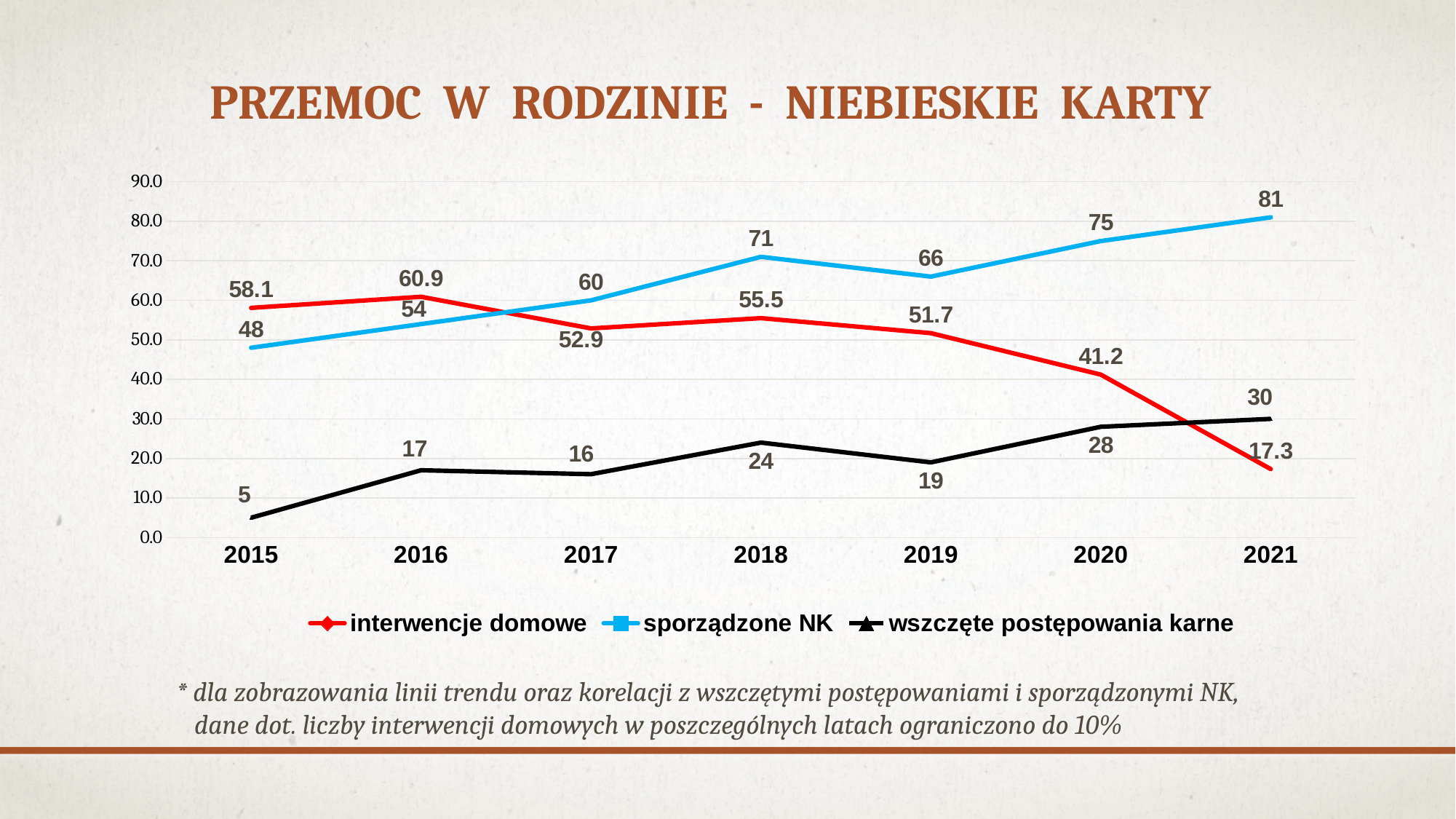
What is the value for interwencje domowe in 2016? 60.9 How many series does the legend list? 3 What kind of chart is shown on the slide? line chart What is the value for wszczęte postępowania karne in 2019? 19 In which year is sporządzone NK highest? 2021 What is the difference between sporządzone NK in 2021 and in 2015? 33 In which year is wszczęte postępowania karne lowest? 2015 Which is larger in 2017: interwencje domowe or sporządzone NK? sporządzone NK What colour is the line for sporządzone NK? blue Does the interwencje domowe series rise or fall from 2018 to 2021? fall How many years are shown on the x axis? 7 What is the value for sporządzone NK in 2018? 71